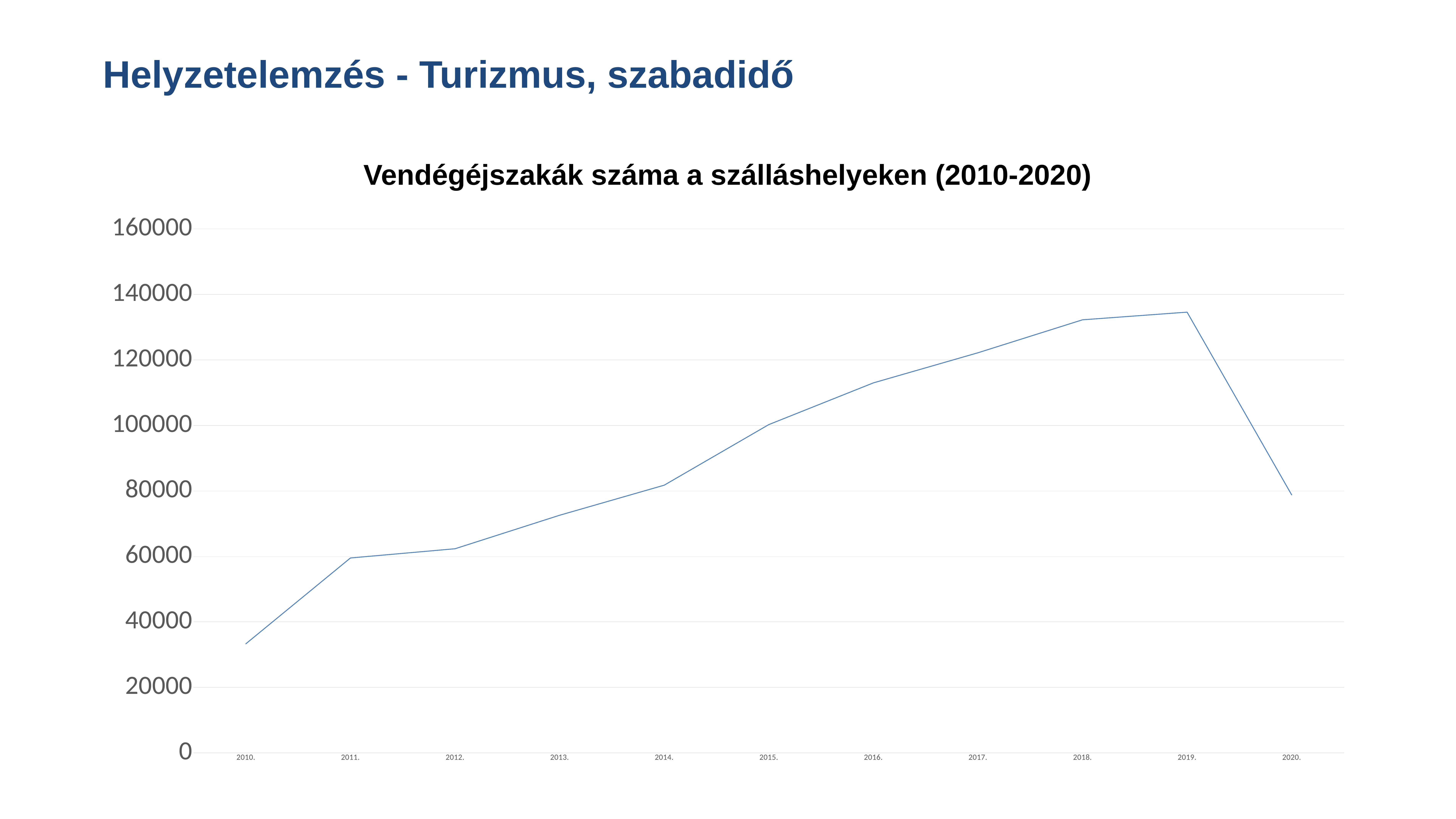
How many years (data points) are plotted on the x axis? 11 Is the value for 2010. greater or less than 40000? less Is the value for 2019. greater or less than 140000? less How does the value change from 2010. to 2019.? it rises Which year has the lowest value? 2010. What kind of chart is shown on the slide? line chart What is the title of the chart? Vendégéjszakák száma a szálláshelyeken (2010-2020) Is the value for 2013. greater or less than 60000? greater Which year has the larger value, 2019. or 2020.? 2019. Which year has the highest value? 2019.